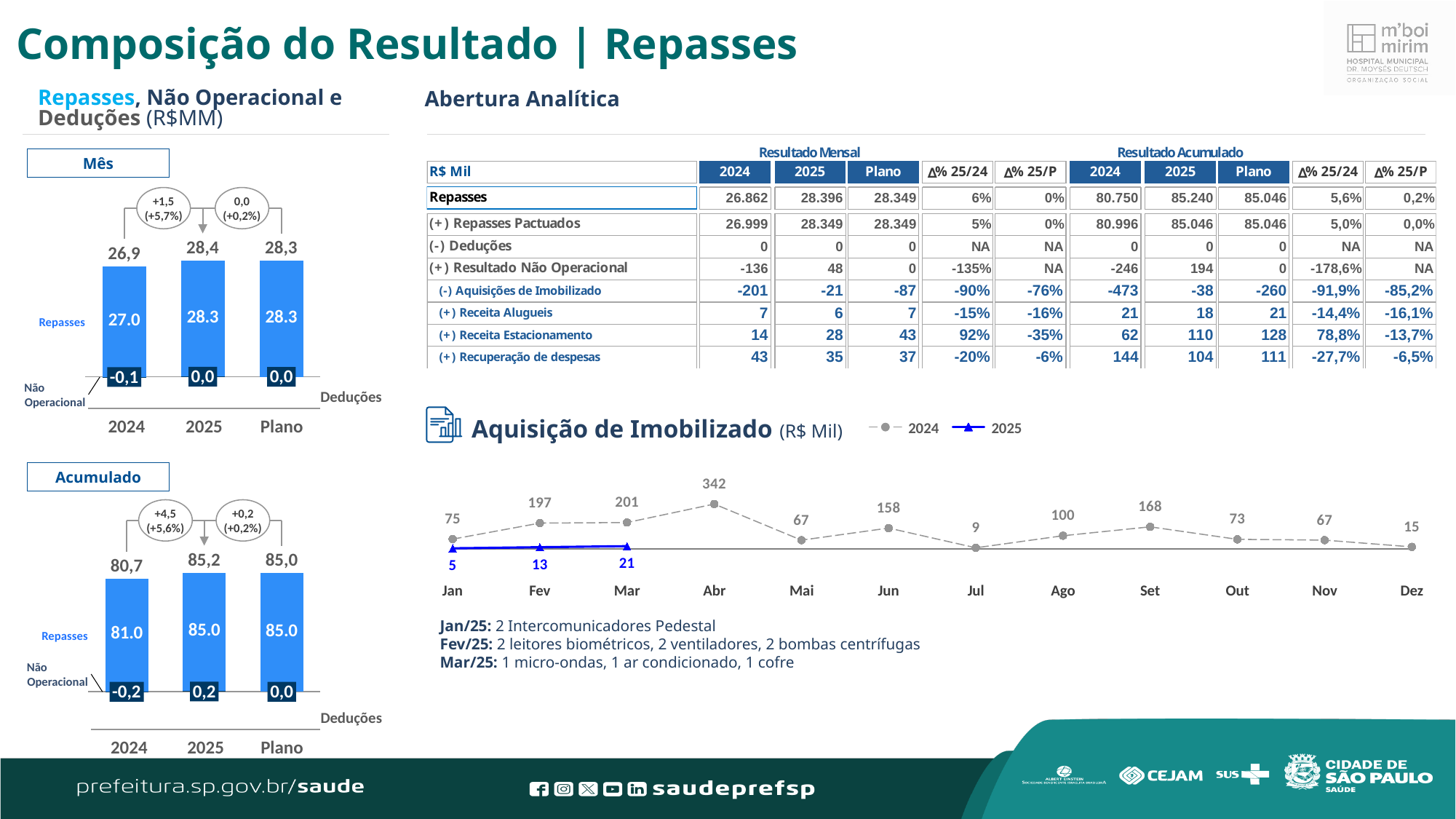
In the 'Acumulado' bar chart, what is the total shown above the 2025 bar? 85,2 In the 'Aquisição de Imobilizado' line chart, what is the 2024 value for Abr? 342 In the 'Aquisição de Imobilizado' line chart, what is the difference between the 2024 and 2025 values for Fev? 184 In the 'Mês' bar chart, what is the Não Operacional value for 2024? -0,1 What kind of chart is the 'Acumulado' chart? bar chart In the 'Aquisição de Imobilizado' line chart, do the 2025 values rise or fall from Jan to Mar? rise In the 'Aquisição de Imobilizado' line chart, how many series does the legend list? 2 In the 'Aquisição de Imobilizado' line chart, which month has the highest 2024 value? Abr In the 'Aquisição de Imobilizado' line chart, which month has the lowest 2024 value? Jul In the 'Aquisição de Imobilizado' line chart, how many months are plotted for the 2025 series? 3 In the 'Mês' bar chart, what is the Repasses value for 2025? 28.3 In the 'Aquisição de Imobilizado' line chart, what is the 2025 value for Mar? 21